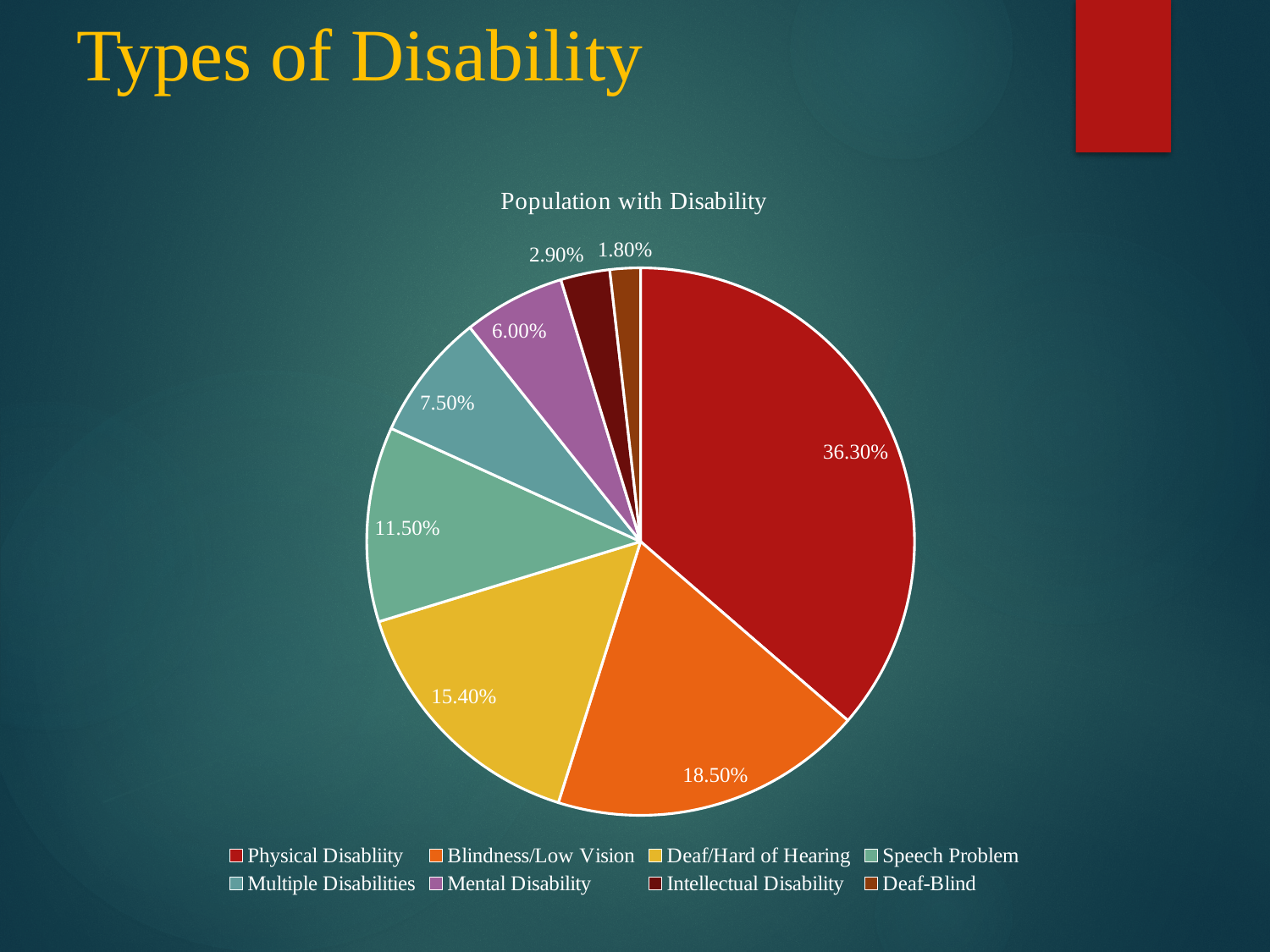
Which category has the largest slice of the pie? Physical Disability What is the difference between the values for Physical Disability and Blindness/Low Vision? 17.80% What is the value for Deaf/Hard of Hearing? 15.40% What is the value for Speech Problem? 11.50% Which is larger, Multiple Disabilities or Mental Disability? Multiple Disabilities What share of the pie is Physical Disability? 36.30% What type of chart is shown on the slide? pie chart What is the value for Deaf-Blind? 1.80% How many categories does the legend list? 8 What is the value for Blindness/Low Vision? 18.50% Which category has the smallest slice of the pie? Deaf-Blind What is the title of the chart? Population with Disability